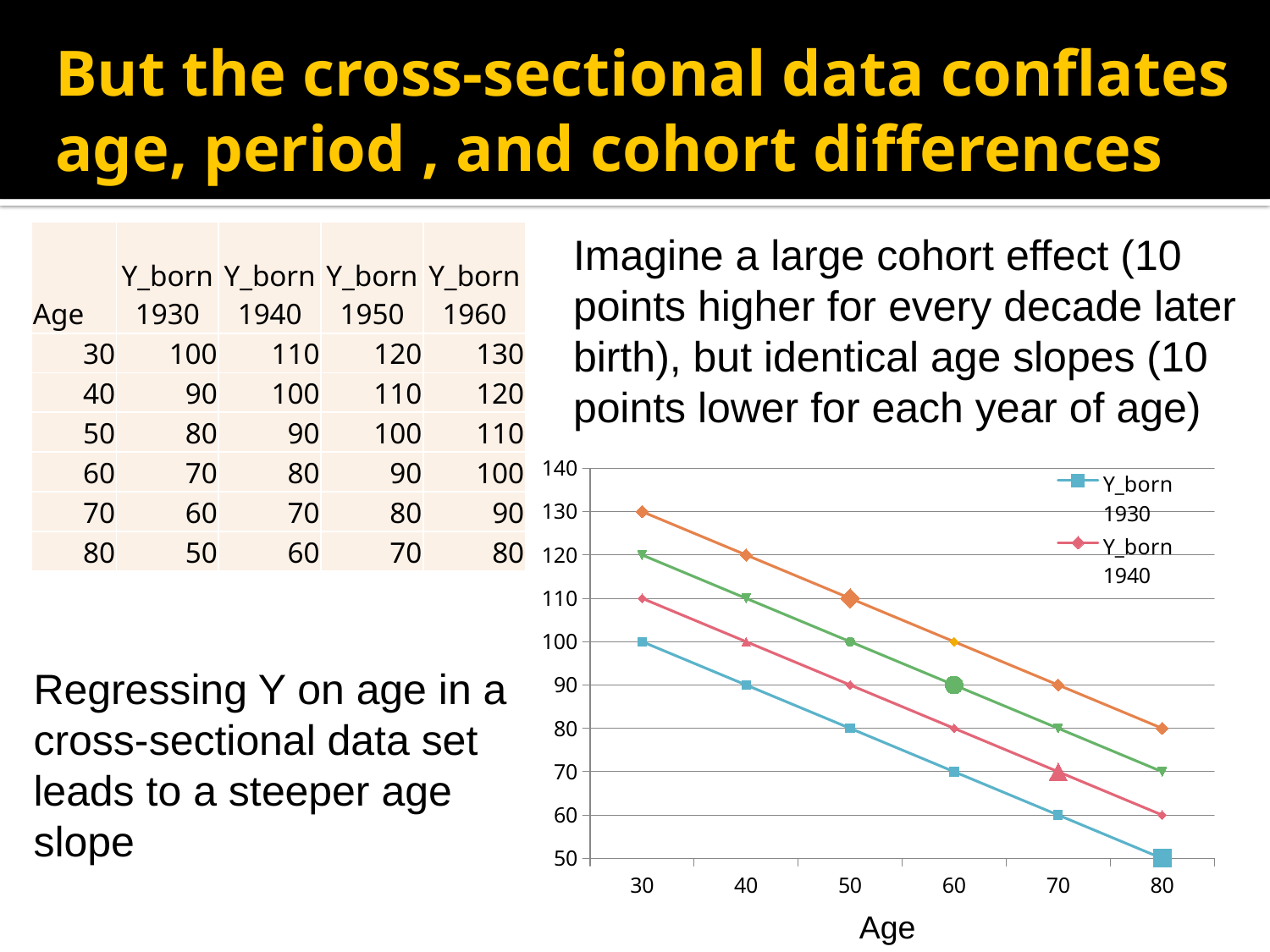
What kind of chart is shown on the slide? line chart How many age points are shown on the x axis of the chart? 6 How many lines are plotted on the chart? 4 What is the value for Y_born 1930 at age 80? 50 What is the value for Y_born 1930 at age 30? 100 What is the value for Y_born 1940 at age 80? 60 At which age does the Y_born 1930 series reach its highest value? 30 What is the difference between Y_born 1940 and Y_born 1930 at age 50? 10 At age 60, which series has the higher value, Y_born 1930 or Y_born 1940? Y_born 1940 What is the title of the x axis of the chart? Age Do the plotted values rise or fall as age increases along the x axis? fall At which age does the Y_born 1940 series reach its lowest value? 80